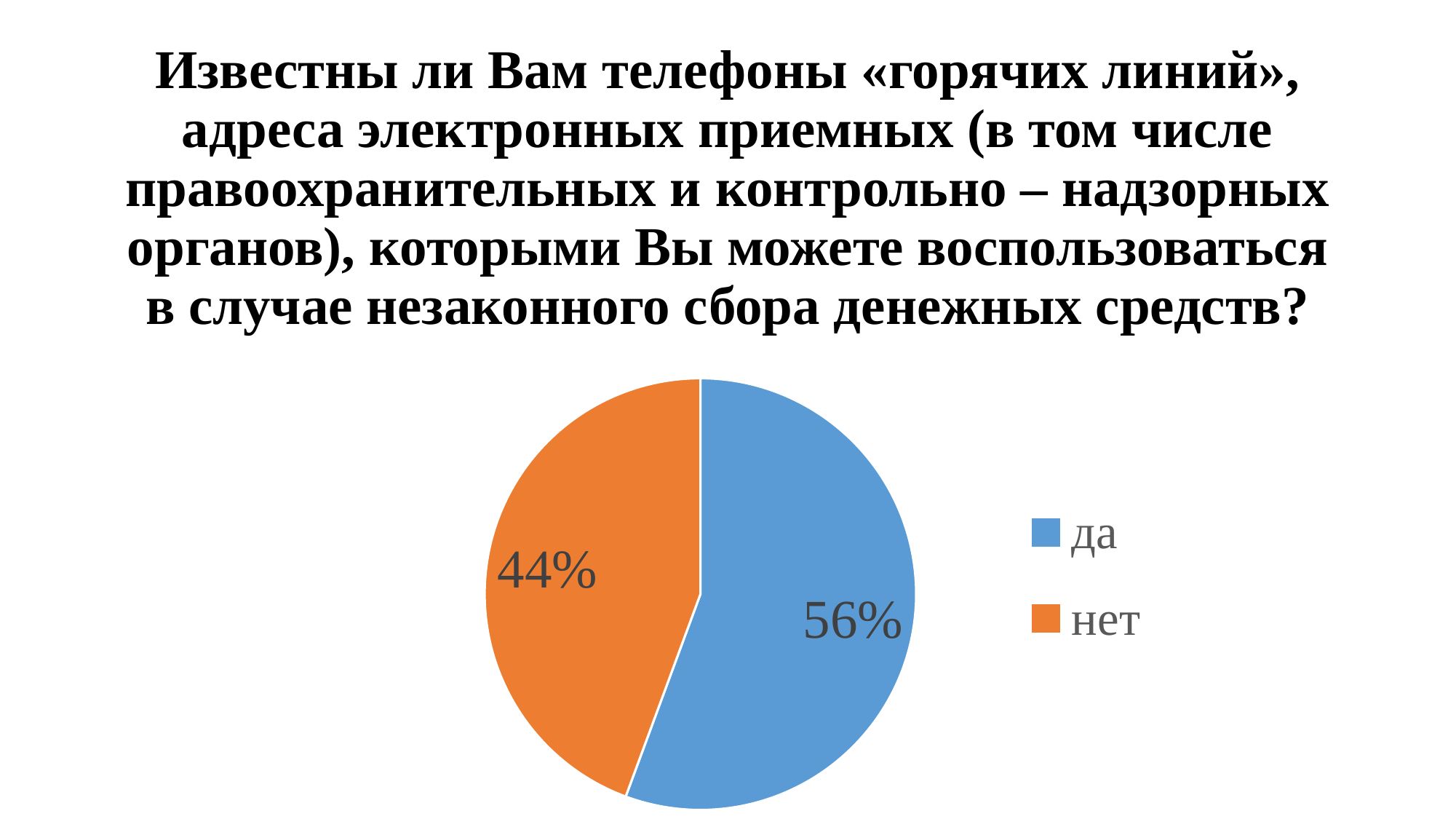
What share of the pie does "да" have? 56% What colour is the "да" slice? blue Which slice is the smallest? нет What kind of chart is shown on the slide? pie chart What colour is the "нет" slice? orange How many slices does the pie chart have? 2 Which is larger, the "да" slice or the "нет" slice? да What is the difference in percentage points between the "да" and "нет" slices? 12 What share of the pie does "нет" have? 44% Which slice is the largest? да Is the share for "да" greater or less than 50%? greater How many entries does the legend list? 2